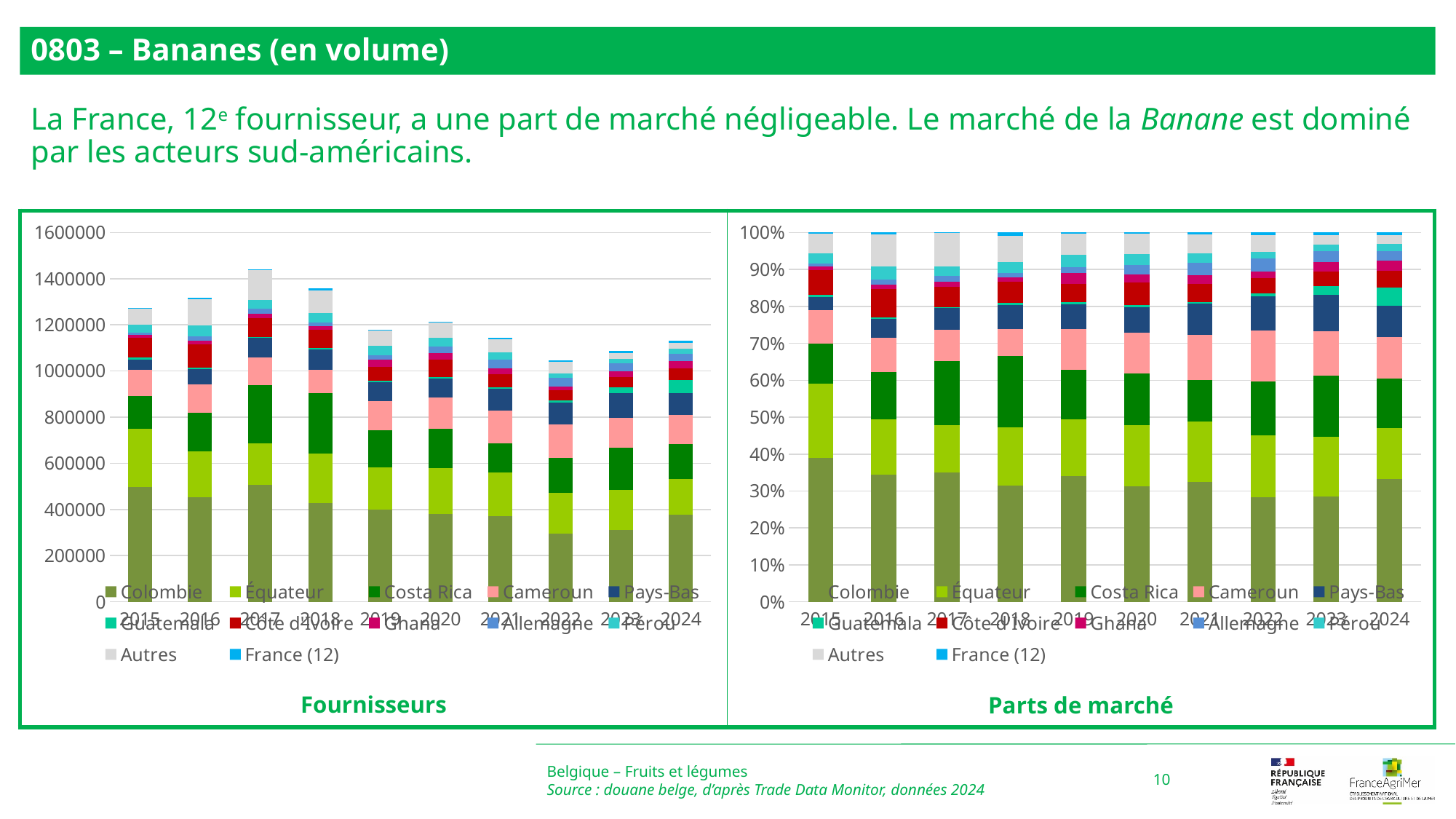
What is the title of the right-hand chart on the slide? Parts de marché In the "Fournisseurs" chart, which total bar is taller, 2017 or 2019? 2017 How many series does the legend of the "Parts de marché" chart list? 12 In the "Parts de marché" chart, which series is plotted at the bottom of each bar? Colombie How many years are shown on the x axis of the "Fournisseurs" chart? 10 In the "Fournisseurs" chart, is the total bar for 2022 greater or less than 1200000? less What kind of chart is the left chart titled "Fournisseurs"? Stacked bar chart In the "Parts de marché" chart, is the Colombie share in 2015 greater or less than 30%? greater In the "Fournisseurs" chart, which year has the tallest total bar? 2017 In the "Fournisseurs" chart, is the total bar for 2015 greater or less than 1200000? greater In the "Fournisseurs" chart, do the total bars rise or fall from 2017 to 2022? fall